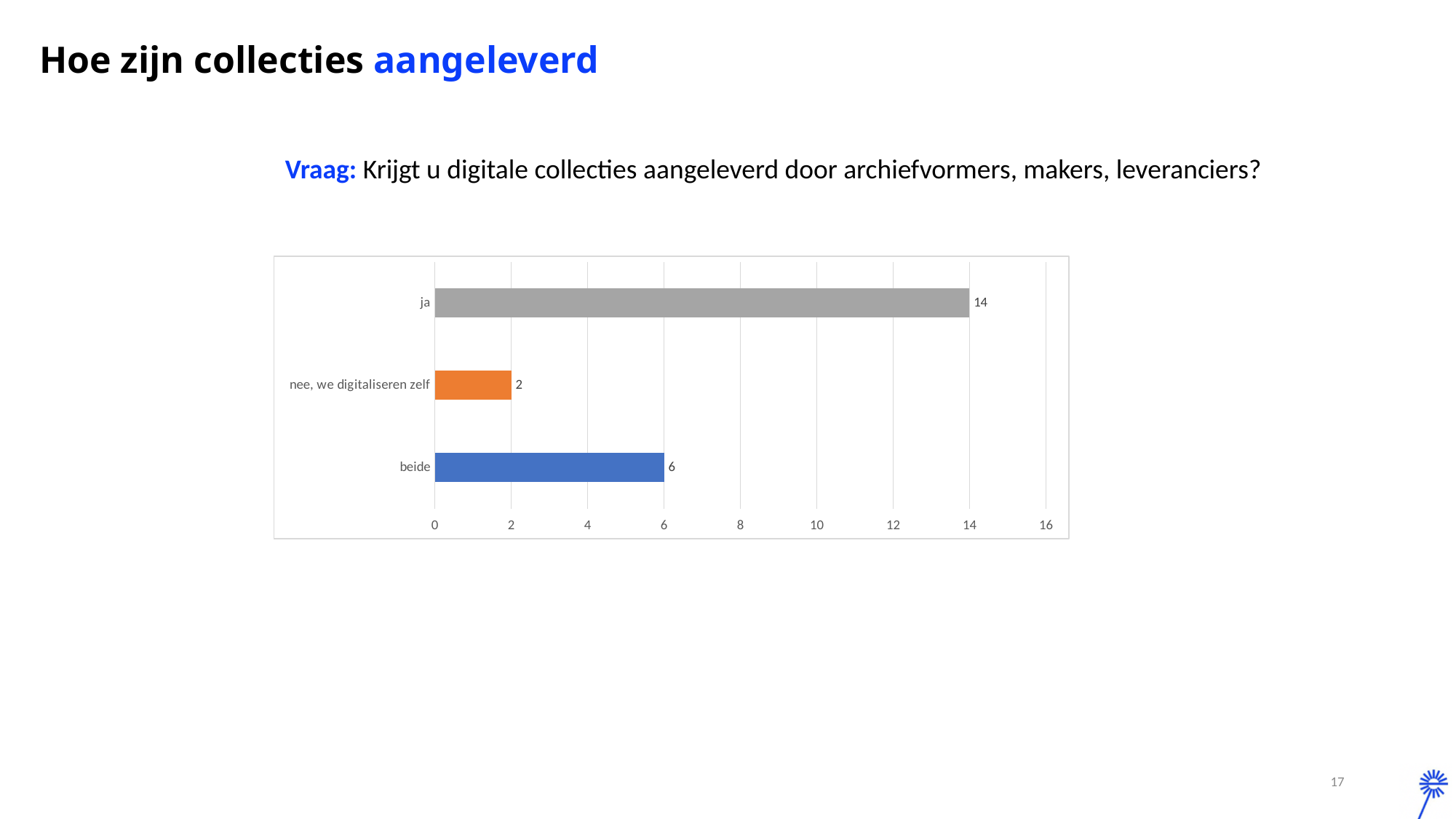
Which category has the lowest value? nee, we digitaliseren zelf What is the value for "ja"? 14 What kind of chart is shown on the slide? bar chart Which category has the highest value? ja What is the difference between the values for "ja" and "beide"? 8 What colour is the bar for "nee, we digitaliseren zelf"? orange What is the difference between the values for "beide" and "nee, we digitaliseren zelf"? 4 Is the value for "ja" greater or less than 10? greater How many categories are shown in the chart? 3 What is the value for "beide"? 6 What is the value for "nee, we digitaliseren zelf"? 2 Which is larger, the value for "beide" or the value for "nee, we digitaliseren zelf"? beide